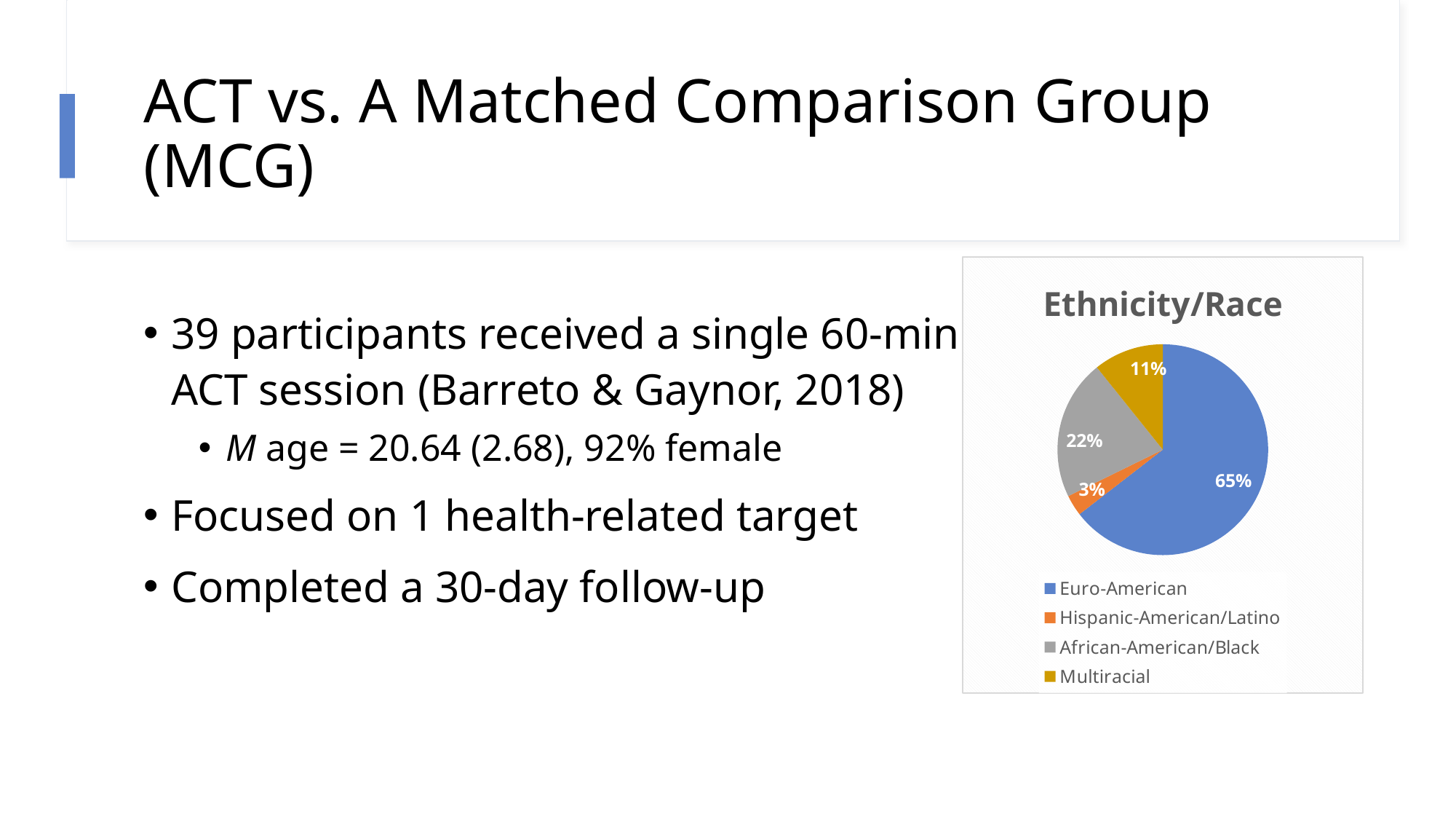
What percentage of the pie is Hispanic-American/Latino? 3% What percentage of the pie is African-American/Black? 22% What percentage of the pie is Euro-American? 65% What type of chart is shown on the slide? pie chart How many categories does the pie chart show? 4 What is the title of the chart? Ethnicity/Race What is the difference in percentage points between Euro-American and African-American/Black? 43 What colour is the Multiracial slice? gold What percentage of the pie is Multiracial? 11% Which category has the smallest share of the pie? Hispanic-American/Latino Which category has the largest share of the pie? Euro-American Which is larger, the share for Multiracial or the share for African-American/Black? African-American/Black